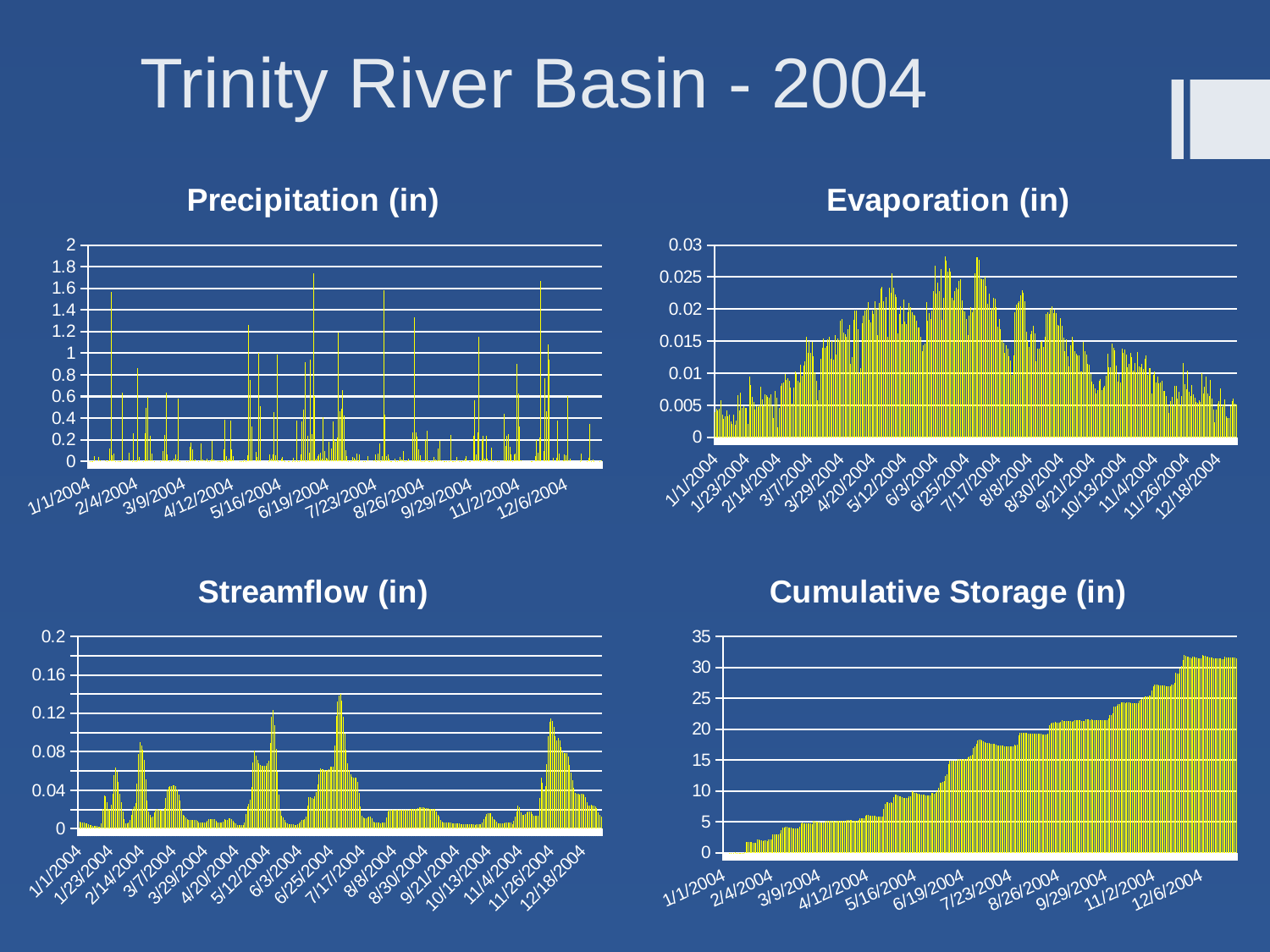
In the Streamflow (in) chart, is the highest value greater or less than 0.12? greater In the Evaporation (in) chart, how do the values change across the year: do they rise steadily, fall steadily, or rise then fall? rise then fall In the Evaporation (in) chart, is the value at 1/1/2004 greater or less than 0.01? less In the Cumulative Storage (in) chart, do the values rise or fall from 1/1/2004 to 12/6/2004? rise In the Evaporation (in) chart, is the highest value greater or less than 0.025? greater How many charts are shown on the slide? 4 What is the top value on the y axis of the Cumulative Storage (in) chart? 35 What kind of chart is the Precipitation (in) chart? bar chart